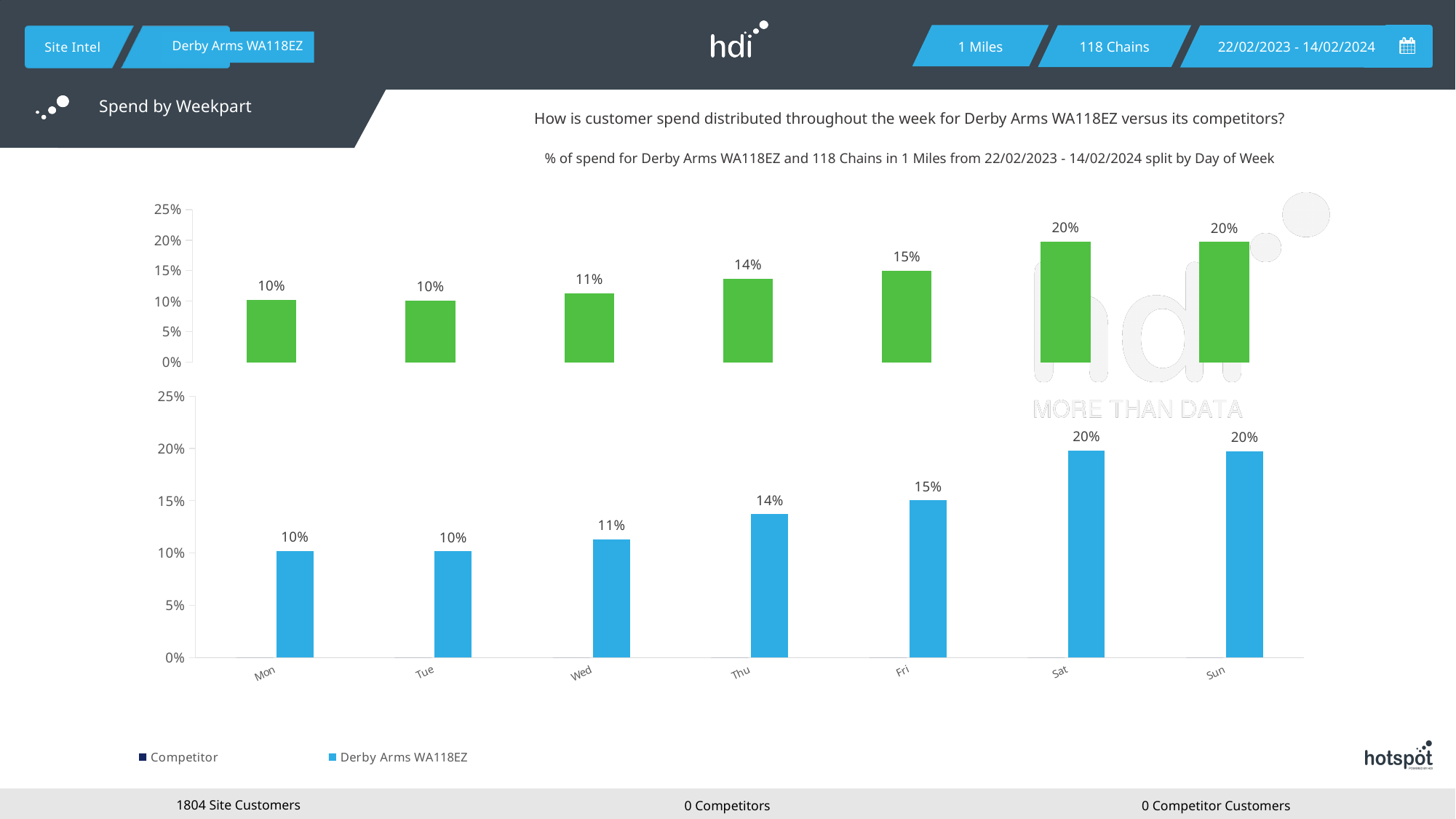
In the bottom chart, what is the value for Wed? 11% How many days of the week are shown on the x axis of the bottom chart? 7 In the bottom chart, do the values generally rise or fall from Mon to Sun? rise In the bottom chart, which is larger, the value for Fri or the value for Wed? Fri In the top chart, what is the value shown on the fifth bar from the left? 15% What kind of chart is the bottom chart? bar chart In the bottom chart, what is the difference between the values for Sun and Mon? 10% In the bottom chart, what is the difference between the values for Fri and Thu? 1% In the bottom chart, what is the value for Sat? 20% In the bottom chart, is the value for Thu greater or less than 10%? greater In the bottom chart, what is the value for Thu? 14% How many series does the legend list? 2